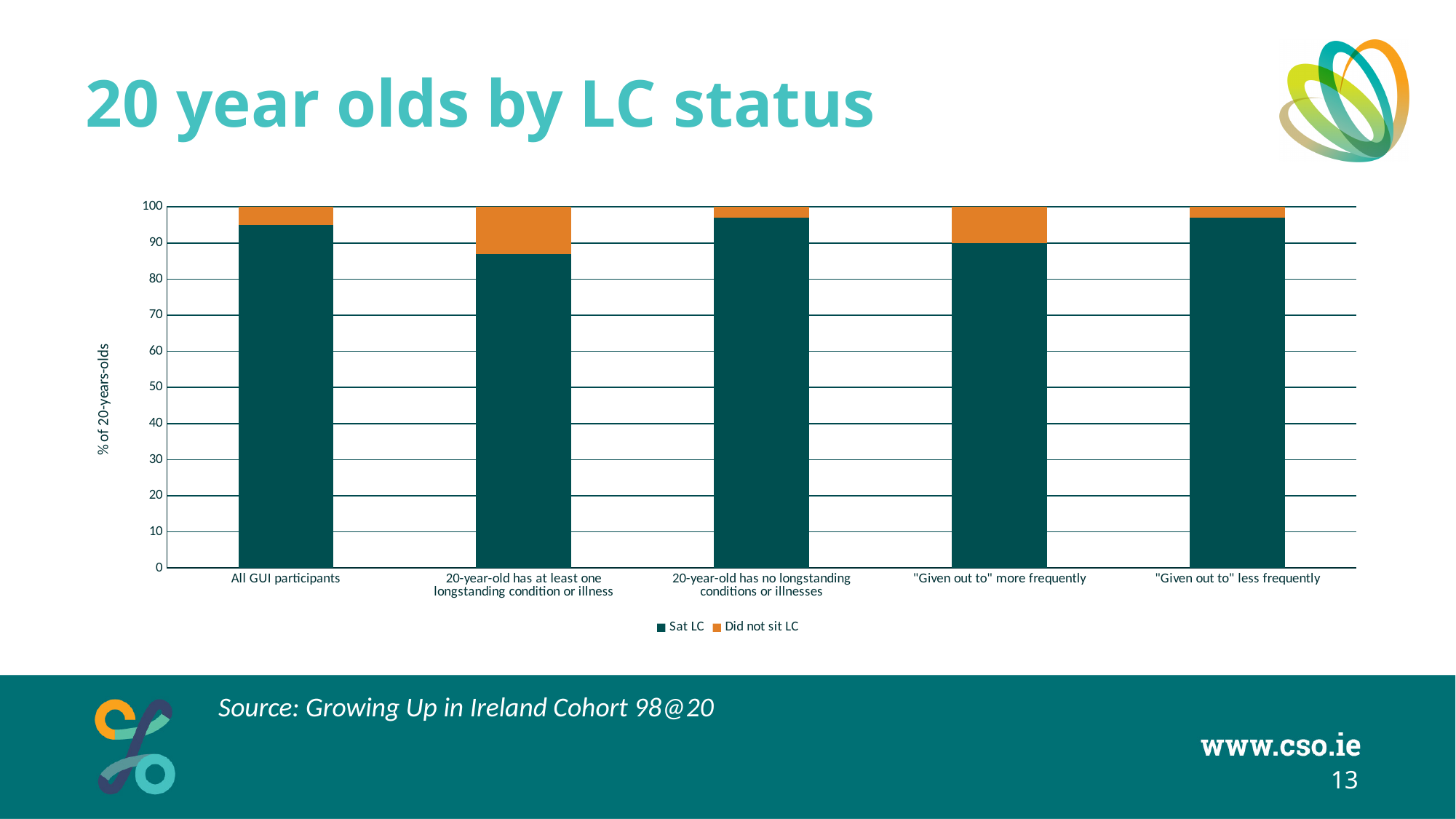
Is the 'Sat LC' value for 20-year-old has at least one longstanding condition or illness greater or less than 90? less What kind of chart is shown on the slide? Stacked bar chart How many categories are shown on the x axis? 5 How many series does the legend list? 2 Which has a larger 'Sat LC' value: '"Given out to" more frequently' or '"Given out to" less frequently'? "Given out to" less frequently Which category has the largest 'Did not sit LC' segment? 20-year-old has at least one longstanding condition or illness What is the label of the y axis? % of 20-years-olds Is the 'Sat LC' value for All GUI participants greater or less than 90? greater Which category has the smallest 'Sat LC' value? 20-year-old has at least one longstanding condition or illness What are the two series listed in the legend? Sat LC and Did not sit LC What is the total height of the stacked bar for All GUI participants? 100 Is the 'Did not sit LC' value for 20-year-old has at least one longstanding condition or illness greater or less than 10? greater